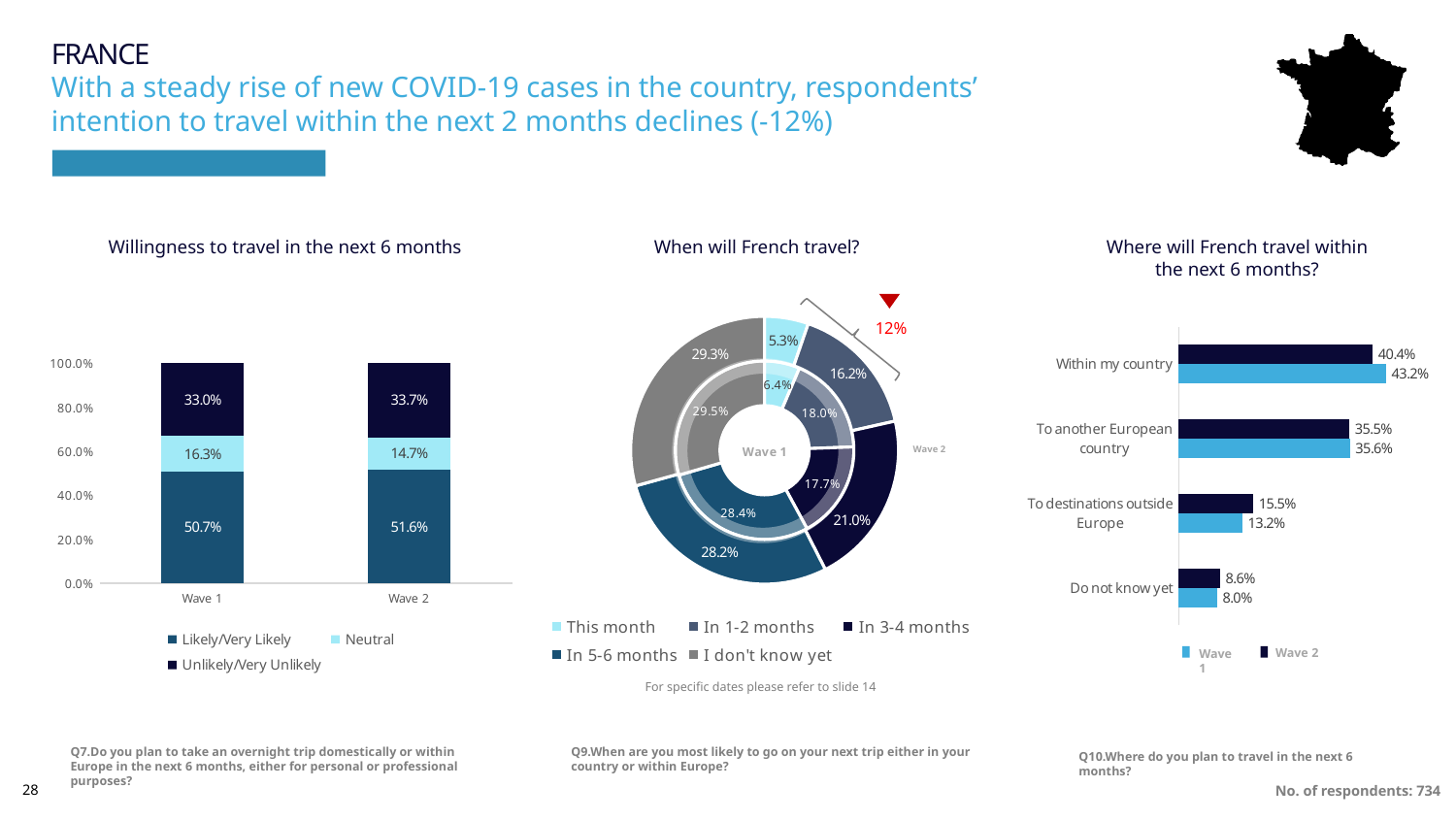
In the 'Where will French travel within the next 6 months?' chart, is the Wave 2 value for 'To destinations outside Europe' larger or smaller than the Wave 1 value? Larger In the 'Where will French travel within the next 6 months?' chart, which category has the lowest values in both waves? Do not know yet In the 'Where will French travel within the next 6 months?' chart, what is the difference between the Wave 2 and Wave 1 values for 'Do not know yet'? 0.6% In the 'When will French travel?' chart, which category has the lowest Wave 2 share? This month In the 'Willingness to travel in the next 6 months' chart, what is the Likely/Very Likely value for Wave 2? 51.6% In the 'Willingness to travel in the next 6 months' chart, what is the Neutral value for Wave 1? 16.3% In the 'Willingness to travel in the next 6 months' chart, how many series does the legend list? 3 In the 'Willingness to travel in the next 6 months' chart, what is the difference between the Unlikely/Very Unlikely values for Wave 2 and Wave 1? 0.7% In the 'When will French travel?' chart, how many categories does the legend list? 5 What kind of chart is 'Willingness to travel in the next 6 months'? Stacked bar chart In the 'When will French travel?' chart, what is the Wave 2 value for 'In 5-6 months'? 28.2% In the 'Where will French travel within the next 6 months?' chart, what is the Wave 1 value for 'Within my country'? 43.2%